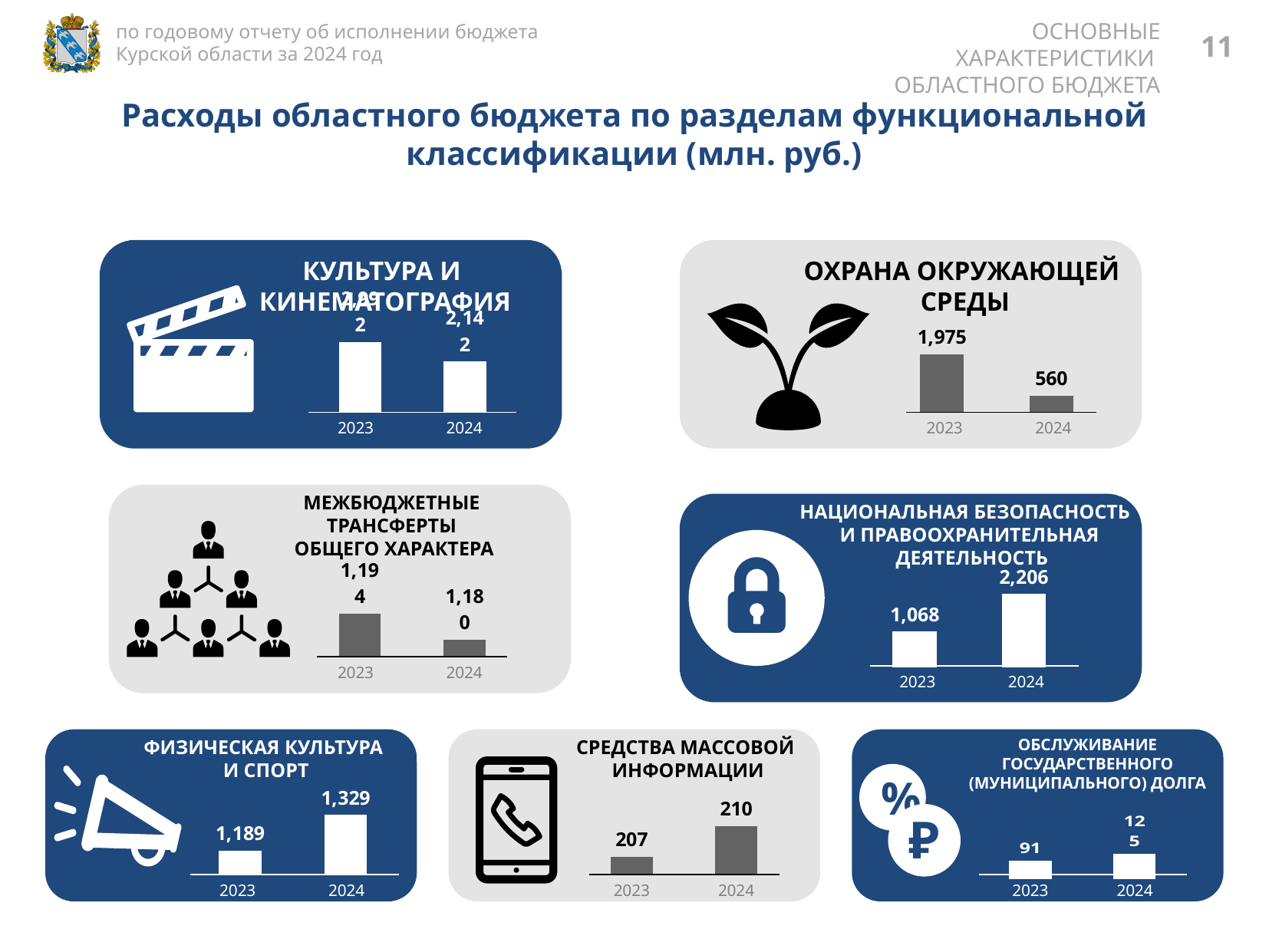
In the 'Охрана окружающей среды' chart, what is the value for 2023? 1,975 In the 'Обслуживание государственного (муниципального) долга' chart, what is the value for 2023? 91 How many small bar charts are shown on the slide? 7 In the 'Физическая культура и спорт' chart, what is the value for 2023? 1,189 In the 'Средства массовой информации' chart, what is the difference between the 2024 and 2023 values? 3 In the 'Национальная безопасность и правоохранительная деятельность' chart, what is the difference between the 2024 and 2023 values? 1,138 In the 'Охрана окружающей среды' chart, what is the value for 2024? 560 In the 'Охрана окружающей среды' chart, what is the difference between the 2023 and 2024 values? 1,415 In the 'Средства массовой информации' chart, what is the value for 2024? 210 In the 'Национальная безопасность и правоохранительная деятельность' chart, which year has the higher value? 2024 In the 'Физическая культура и спорт' chart, do the values rise or fall from 2023 to 2024? rise In the 'Национальная безопасность и правоохранительная деятельность' chart, what is the value for 2024? 2,206